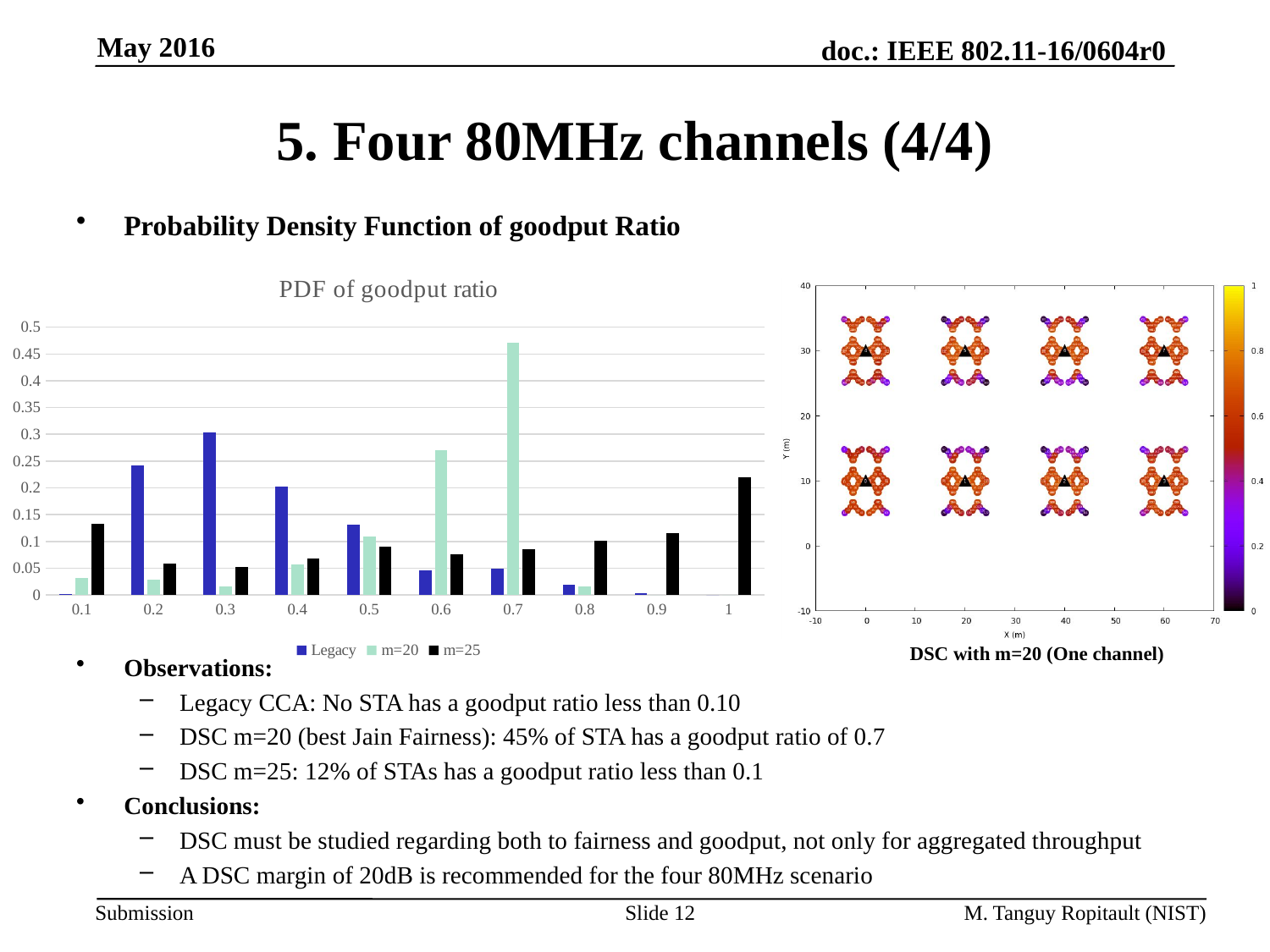
In the 'PDF of goodput ratio' chart, at goodput ratio 0.6, which series has the larger value: Legacy or m=20? m=20 How many series does the legend of the 'PDF of goodput ratio' chart list? 3 What are the three legend entries of the 'PDF of goodput ratio' chart? Legacy, m=20, m=25 In the 'PDF of goodput ratio' chart, at which goodput ratio is the m=25 series highest? 1 How many goodput ratio categories are shown on the x axis of the 'PDF of goodput ratio' chart? 10 In the 'PDF of goodput ratio' chart, is the m=20 value at goodput ratio 0.7 greater or less than 0.4? greater In the 'PDF of goodput ratio' chart, at which goodput ratio is the m=20 series highest? 0.7 In the 'PDF of goodput ratio' chart, is the Legacy value at goodput ratio 0.3 greater or less than 0.2? greater In the 'PDF of goodput ratio' chart, is the m=25 value at goodput ratio 0.1 greater or less than 0.2? less In the 'PDF of goodput ratio' chart, at which goodput ratio is the Legacy series highest? 0.3 What kind of chart is the 'PDF of goodput ratio' chart? bar chart In the 'PDF of goodput ratio' chart, at goodput ratio 0.2, which series has the larger value: Legacy or m=25? Legacy